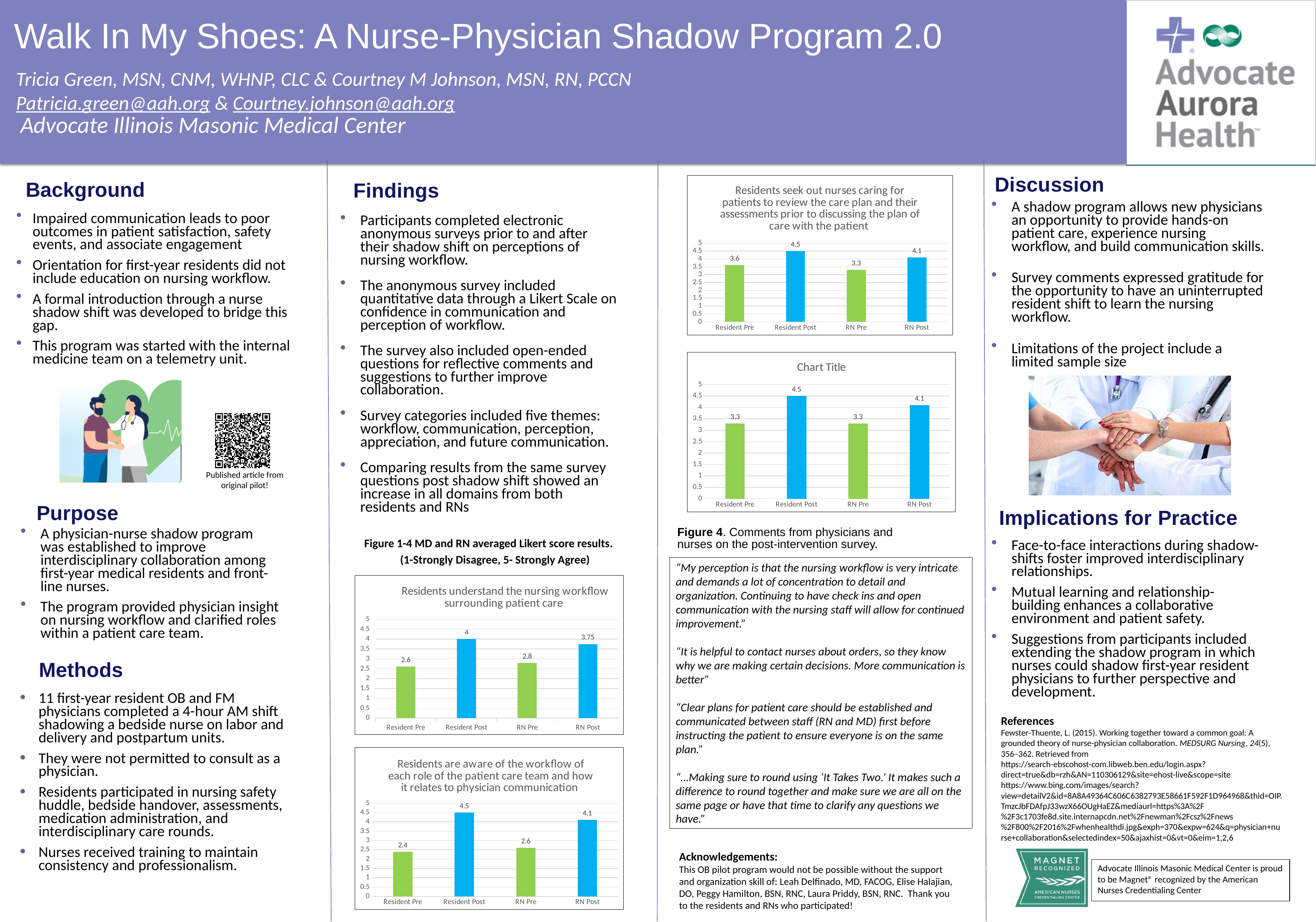
In the chart titled 'Residents understand the nursing workflow surrounding patient care', which category has the lowest value? Resident Pre In the chart titled 'Chart Title' (top right, second chart), how many categories are shown on the x axis? 4 In the chart titled 'Residents understand the nursing workflow surrounding patient care', what is the difference between RN Post and RN Pre? 0.95 In the chart titled 'Residents are aware of the workflow of each role of the patient care team and how it relates to physician communication', which category has the highest value? Resident Post In the chart titled 'Residents seek out nurses caring for patients to review the care plan and their assessments prior to discussing the plan of care with the patient', which is larger, Resident Pre or RN Pre? Resident Pre What kind of chart is the chart titled 'Residents understand the nursing workflow surrounding patient care'? Bar chart In the chart titled 'Chart Title' (top right, second chart), is the value for Resident Post greater or less than 4? greater In the chart titled 'Chart Title' (top right, second chart), what is the value for RN Post? 4.1 In the chart titled 'Residents seek out nurses caring for patients to review the care plan and their assessments prior to discussing the plan of care with the patient', what is the value for RN Pre? 3.3 In the chart titled 'Residents are aware of the workflow of each role of the patient care team and how it relates to physician communication', what is the value for Resident Pre? 2.4 In the chart titled 'Residents understand the nursing workflow surrounding patient care', what is the value for Resident Post? 4 In the chart titled 'Residents are aware of the workflow of each role of the patient care team and how it relates to physician communication', what is the difference between Resident Post and Resident Pre? 2.1